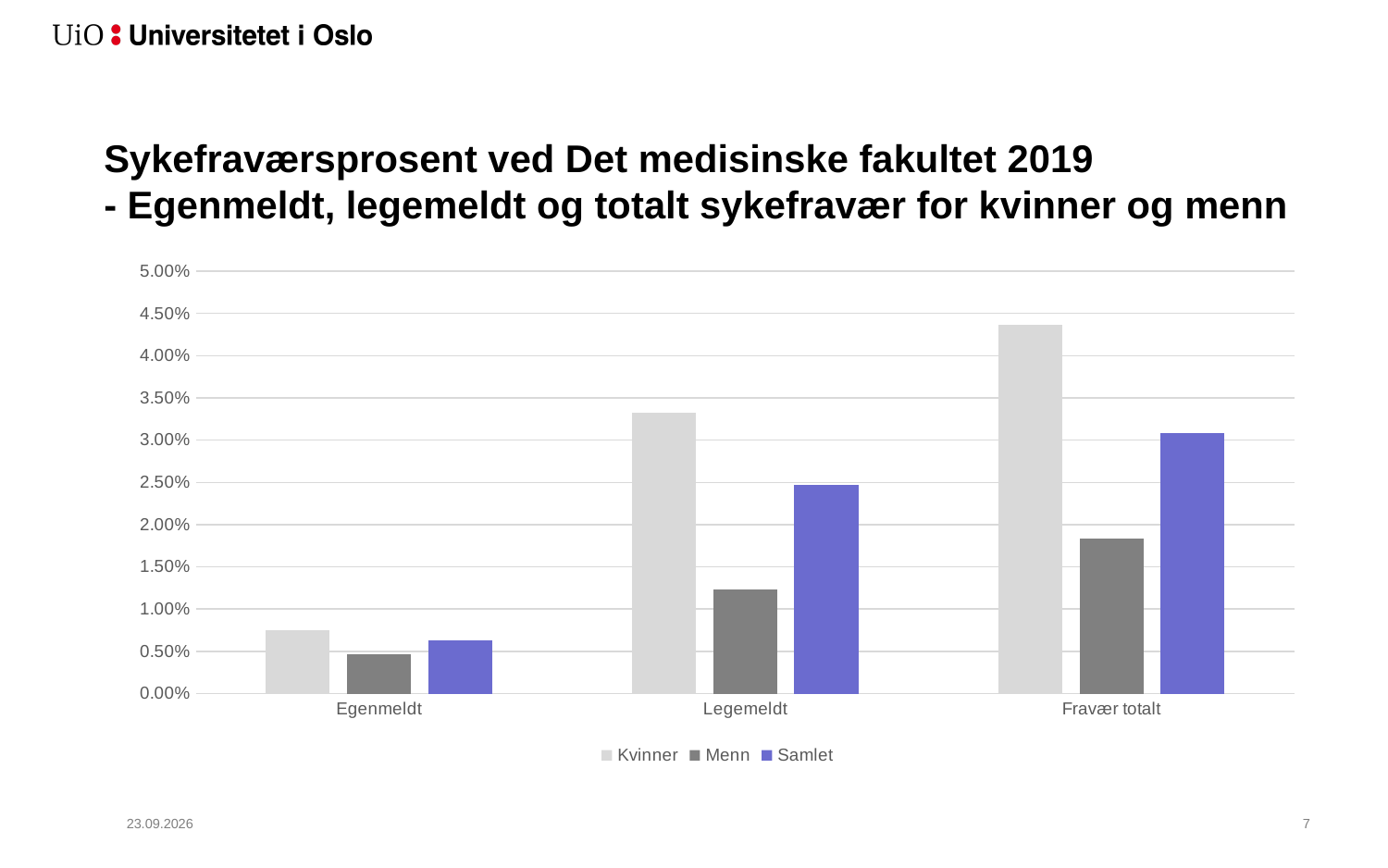
Do the Menn values rise or fall from Egenmeldt to Fravær totalt along the x axis? rise What kind of chart is shown on the slide? bar chart Which category has the highest value for Kvinner? Fravær totalt Is the value for Kvinner in Legemeldt greater or less than 3.00%? greater Which series has the highest bar in the Fravær totalt category? Kvinner Is the value for Kvinner in Fravær totalt greater or less than 4.00%? greater How many categories are shown on the x axis? 3 How many series does the legend list? 3 Which is larger, the Samlet value for Legemeldt or the Samlet value for Egenmeldt? Legemeldt Which category has the lowest value for Menn? Egenmeldt Is the value for Menn in Fravær totalt greater or less than 2.00%? less Which series has the lowest bar in the Legemeldt category? Menn